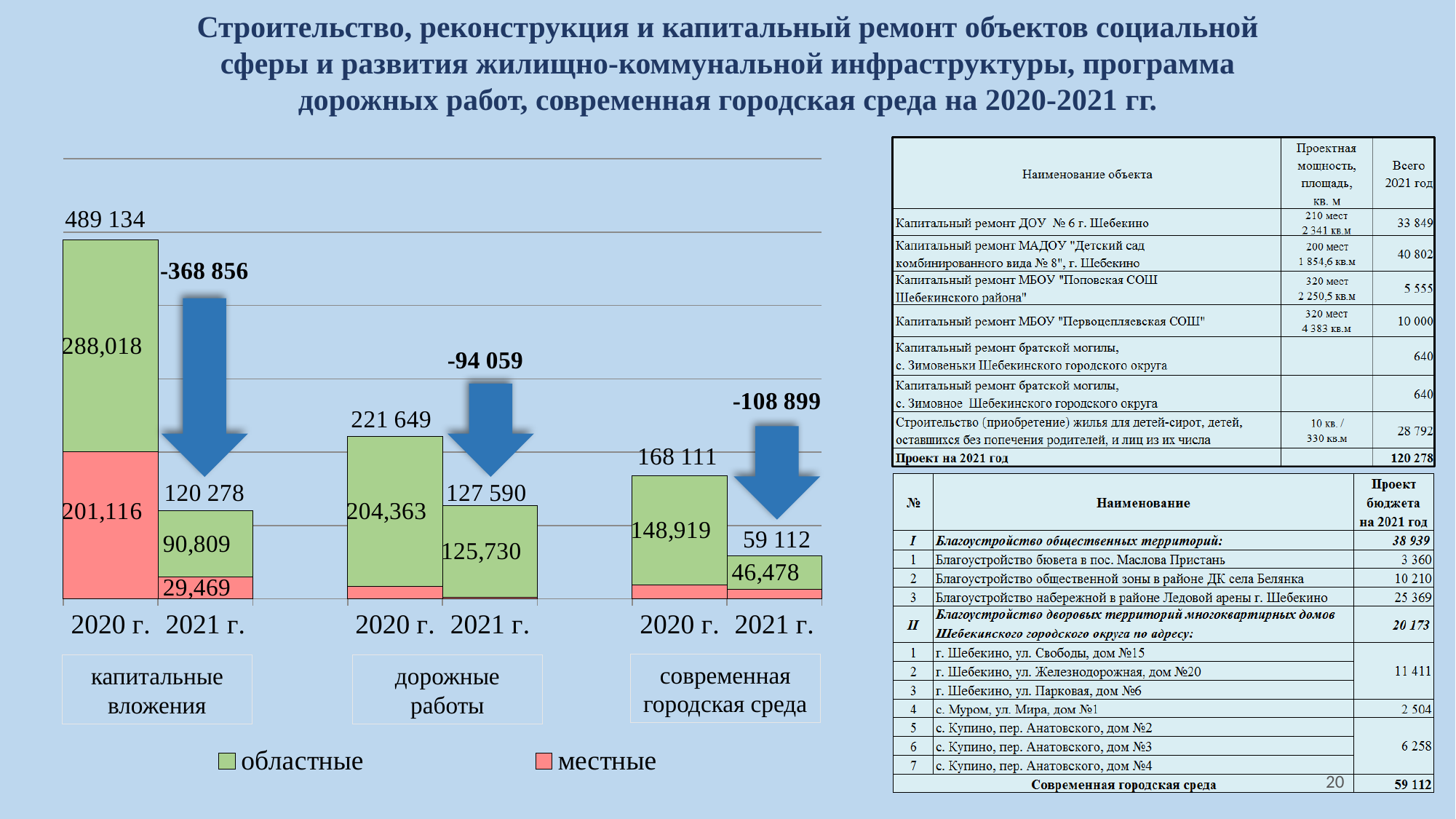
What is the местные value for капитальные вложения in 2021 г.? 29,469 What is the total of the 2021 г. bar for современная городская среда? 59 112 Which bar has the lowest total in the chart? современная городская среда, 2021 г. What is the областные value for современная городская среда in 2020 г.? 148,919 What kind of chart is shown on the left of the slide? stacked bar chart What is the difference between the 2020 г. and 2021 г. totals for капитальные вложения? 368 856 What is the областные value for капитальные вложения in 2020 г.? 288,018 Which is larger: the областные value for капитальные вложения in 2021 г. or the областные value for дорожные работы in 2021 г.? дорожные работы in 2021 г. What is the областные value for дорожные работы in 2021 г.? 125,730 Which bar has the highest total in the chart? капитальные вложения, 2020 г. What is the total of the 2020 г. bar for дорожные работы? 221 649 How many series does the chart legend list? 2